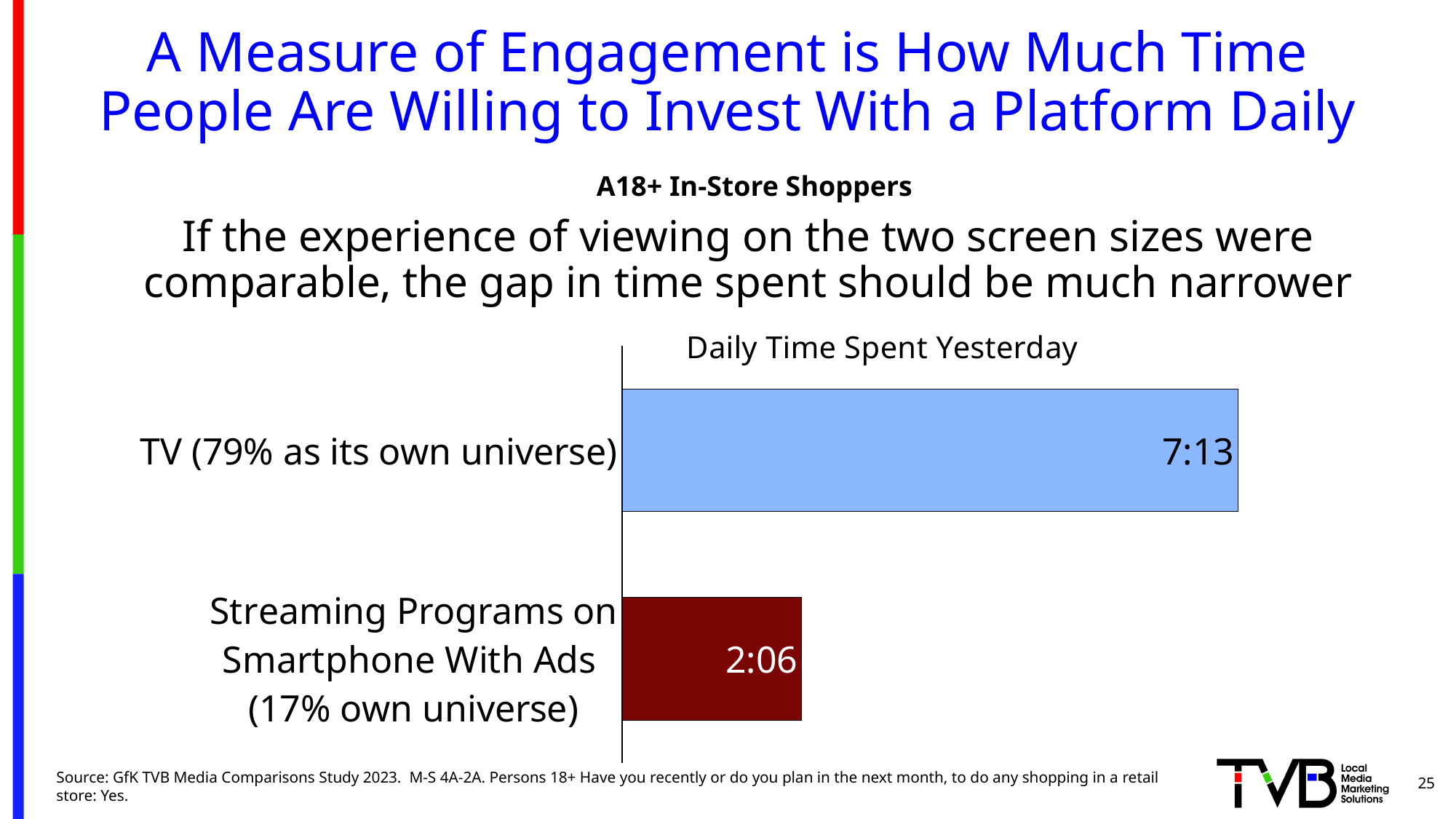
What kind of chart is shown on the slide? Bar chart What is the daily time spent yesterday for Streaming Programs on Smartphone With Ads (17% own universe)? 2:06 What is the daily time spent yesterday for TV (79% as its own universe)? 7:13 What colour is the bar for Streaming Programs on Smartphone With Ads? Dark red Which category has the lowest daily time spent yesterday? Streaming Programs on Smartphone With Ads (17% own universe) Which is larger: the daily time spent for TV or for Streaming Programs on Smartphone With Ads? TV How many categories are shown in the chart? 2 What is the difference in daily time spent between TV and Streaming Programs on Smartphone With Ads? 5:07 Which category has the highest daily time spent yesterday? TV (79% as its own universe) What is the title of the chart? Daily Time Spent Yesterday